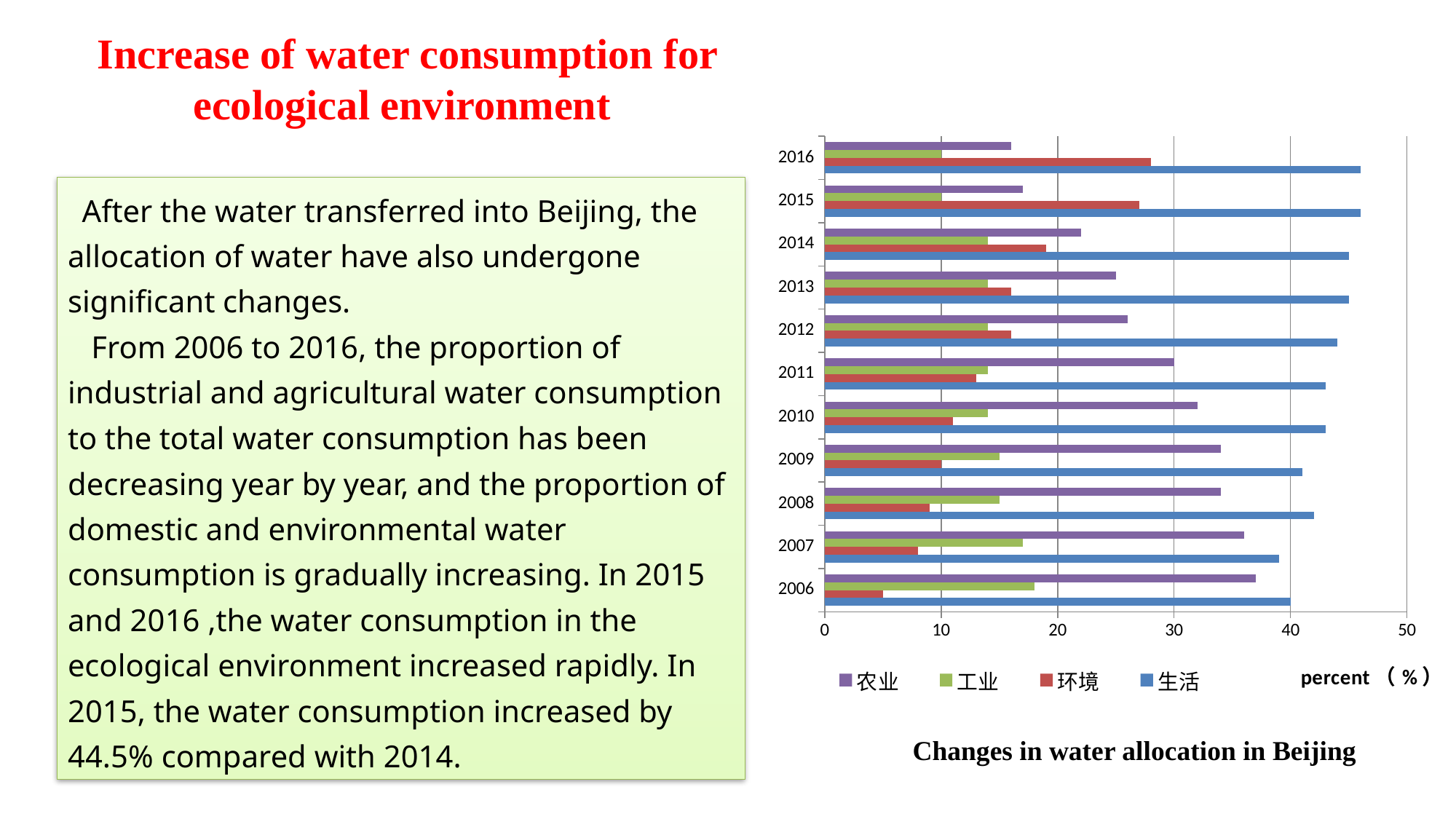
Which series has the lowest value in 2006? 环境 Does the value for 农业 rise or fall from 2006 to 2016? fall What unit is indicated for the chart's horizontal axis? percent (%) How many years are shown on the chart's vertical axis? 11 Is the value for 生活 in 2016 greater or less than 40? greater What kind of chart is shown on the slide? bar chart Is the value for 环境 in 2006 greater or less than 10? less Is the value for 农业 in 2006 greater or less than 30? greater Which series has the highest value in 2016? 生活 What is the caption/title given below the chart? Changes in water allocation in Beijing How many series does the chart legend list? 4